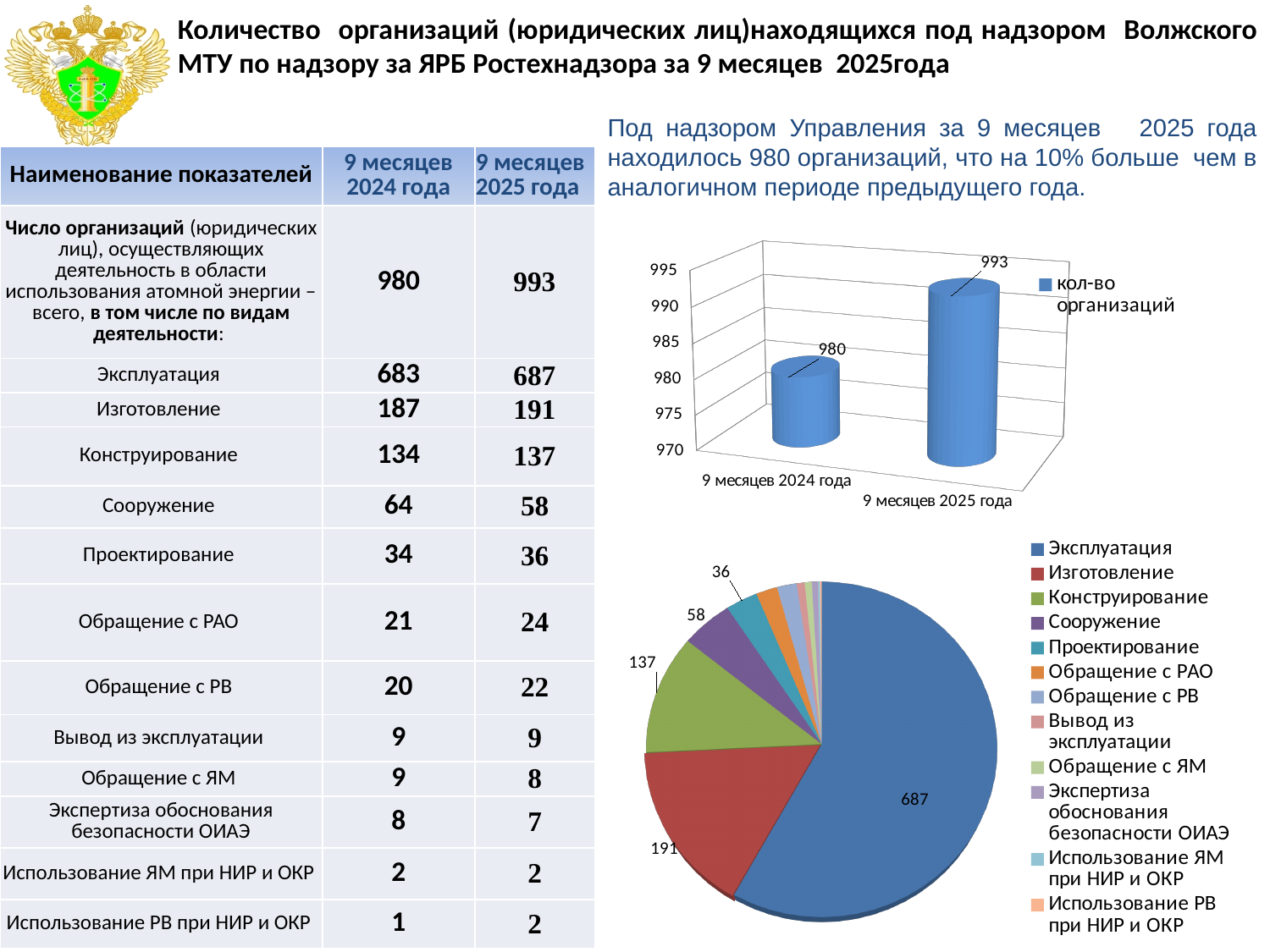
In the upper bar chart, what is the name of the series shown in the legend? кол-во организаций In the lower pie chart, how many categories does the legend list? 12 In the upper bar chart, what is the difference between the values for 9 месяцев 2025 года and 9 месяцев 2024 года? 13 In the lower pie chart, which is larger: Изготовление or Конструирование? Изготовление In the lower pie chart, what is the value for Эксплуатация? 687 What kind of chart is the lower chart on the right side of the slide? pie chart In the upper bar chart, which category has the higher value? 9 месяцев 2025 года In the lower pie chart, which category has the largest slice? Эксплуатация What kind of chart is the upper chart on the right side of the slide? bar chart In the upper bar chart, how many categories are shown on the x axis? 2 In the upper bar chart, what is the value for 9 месяцев 2025 года? 993 In the upper bar chart, what is the value for 9 месяцев 2024 года? 980